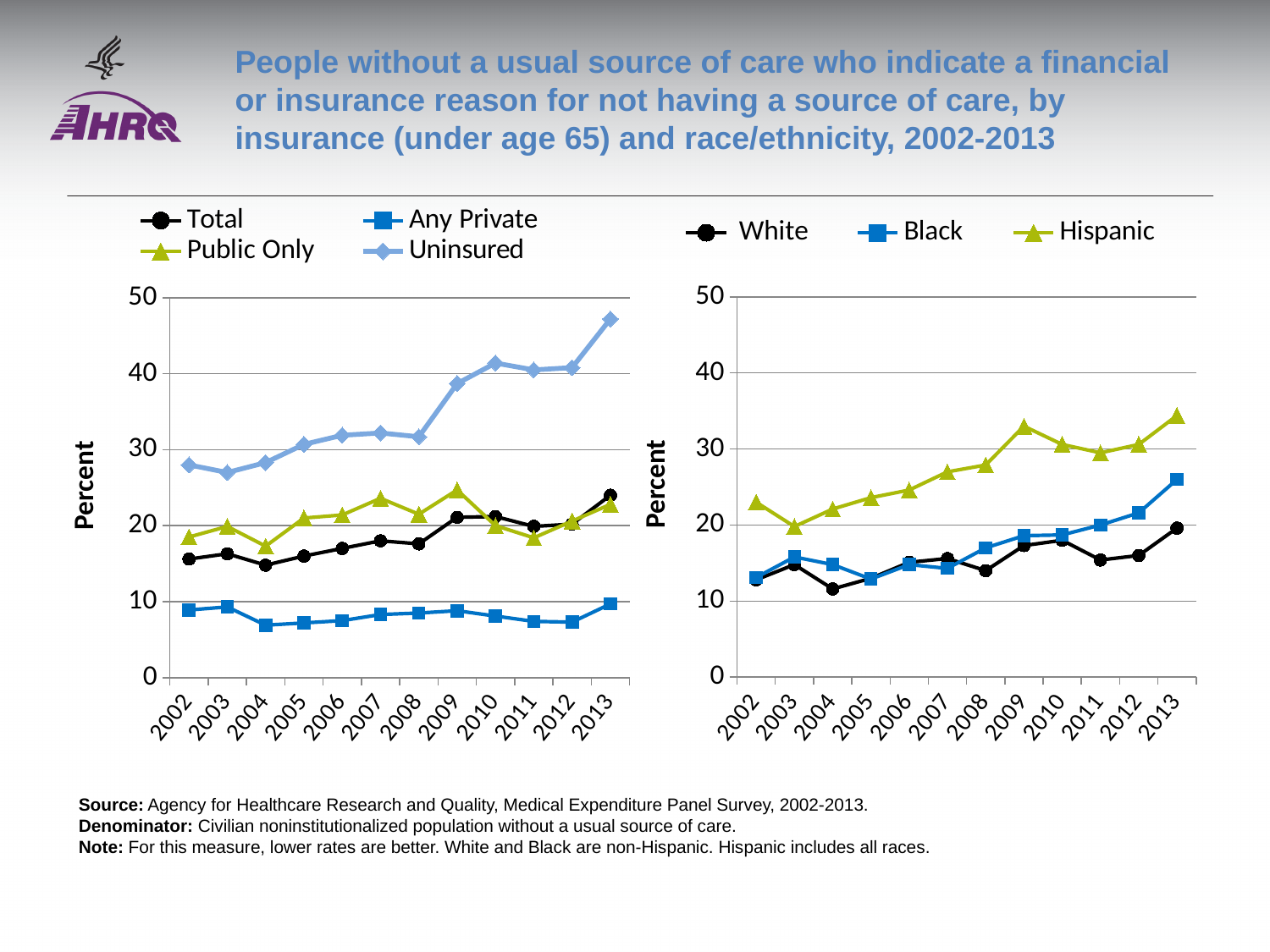
In the left chart (insurance), is the value for Uninsured in 2013 greater or less than 40? greater In the left chart (insurance), is the value for Uninsured in 2002 greater or less than 30? less In the left chart (insurance), do the values for Uninsured generally rise or fall from 2002 to 2013? rise In the right chart (race/ethnicity), is the value for Hispanic in 2013 greater or less than 30? greater How many series does the legend of the right chart (race/ethnicity) list? 3 What kind of chart is the left chart (insurance)? line chart In the right chart (race/ethnicity), which is larger in 2013, Black or White? Black In the right chart (race/ethnicity), which series has the highest values across the years? Hispanic How many years are plotted along the x axis of the right chart (race/ethnicity)? 12 In the left chart (insurance), which series has the lowest values across the years? Any Private In the left chart (insurance), which series has the highest values across the years? Uninsured How many series does the legend of the left chart (insurance) list? 4